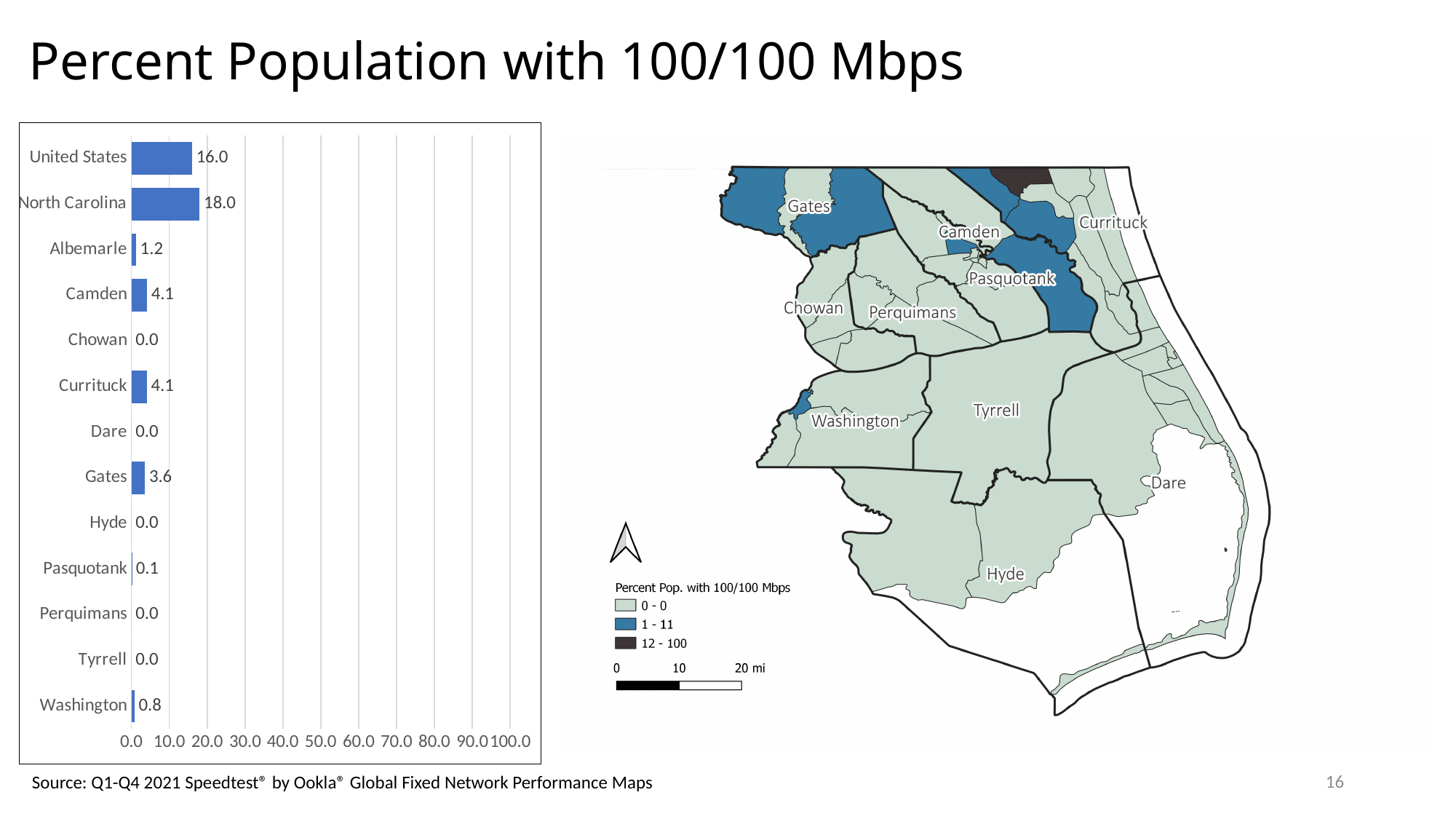
What kind of chart is shown on the left of the slide? bar chart How many categories in the bar chart have a value of 0.0? 5 Which category has the highest value in the bar chart? North Carolina What is the value for Washington in the bar chart? 0.8 What is the value for Camden in the bar chart? 4.1 What is the difference between the values for North Carolina and the United States in the bar chart? 2.0 Is the value for the United States in the bar chart greater or less than 10.0? greater What is the value for Gates in the bar chart? 3.6 What is the difference between the values for Camden and Albemarle in the bar chart? 2.9 What is the value for North Carolina in the bar chart? 18.0 How many categories are shown in the bar chart? 13 Which is larger in the bar chart, the value for Gates or the value for Pasquotank? Gates